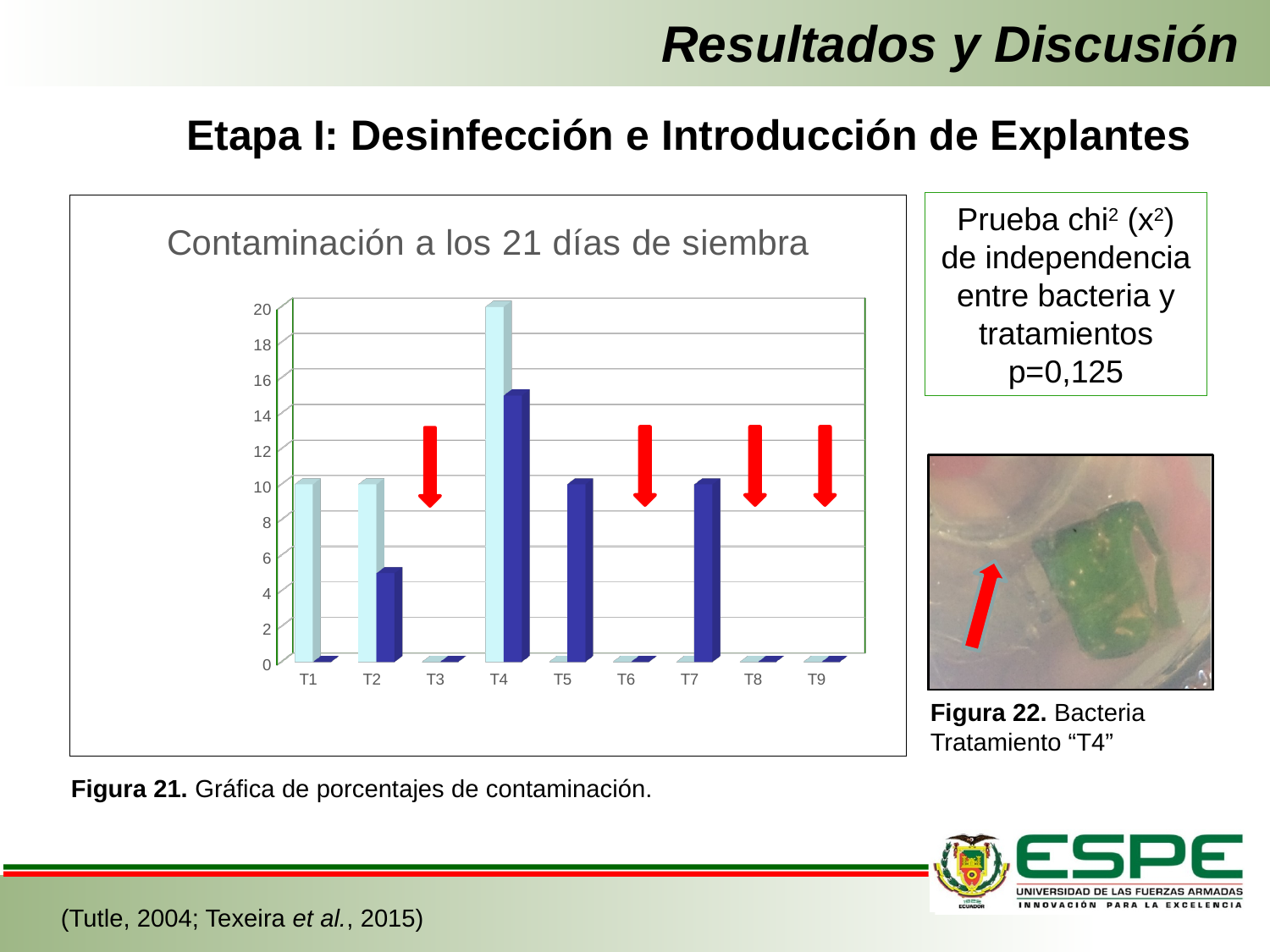
Is the value of the light blue bar for T4 greater or less than 16? greater Which treatment has the tallest bar in the chart? T4 Which treatments in the chart are marked with red arrows? T3, T6, T8, T9 Is the value of the dark blue bar for T7 greater or less than 6? greater Which is larger, the dark blue bar for T2 or the dark blue bar for T5? T5 What kind of chart is shown on the slide? bar chart What is the title of the chart? Contaminación a los 21 días de siembra How many treatment categories are shown on the x axis of the chart? 9 Which is larger, the light blue bar for T4 or the light blue bar for T1? T4 What value does the light blue bar for T4 reach on the y axis? 20 Is the value of the dark blue bar for T4 greater or less than 12? greater